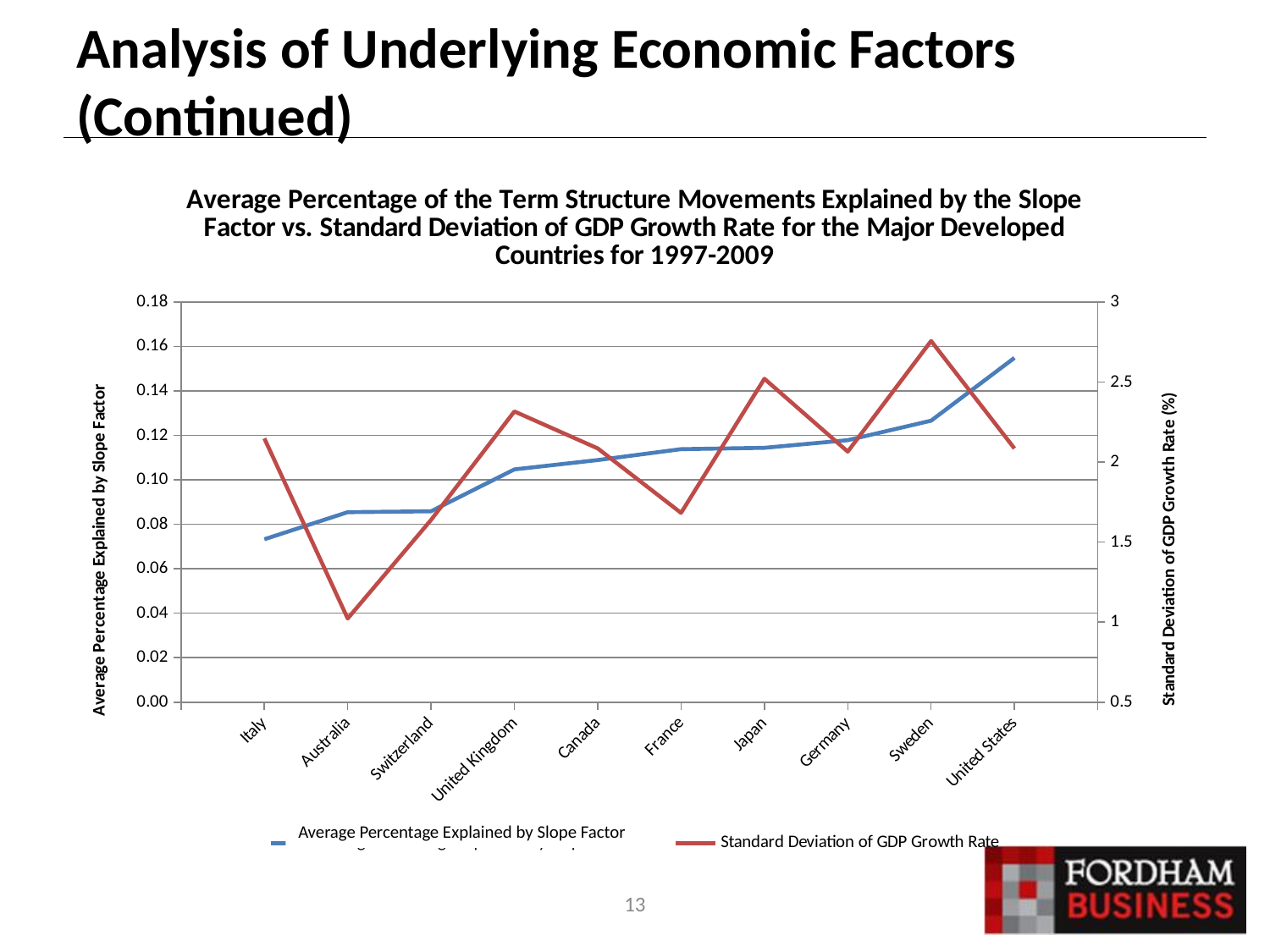
How many countries are plotted along the x axis? 10 Is the Standard Deviation of GDP Growth Rate for Australia greater or less than 1.5? less What is the label of the right-hand vertical axis? Standard Deviation of GDP Growth Rate (%) How many series does the legend list? 2 Which country has the highest Standard Deviation of GDP Growth Rate? Sweden Which country has the lowest Standard Deviation of GDP Growth Rate? Australia Does the Average Percentage Explained by Slope Factor generally rise or fall from Italy to the United States along the x axis? rise Is the Average Percentage Explained by Slope Factor for the United States greater or less than 0.14? greater What kind of chart is shown on the slide? line chart Which country has the highest value for Average Percentage Explained by Slope Factor? United States Is the Average Percentage Explained by Slope Factor for Italy greater or less than 0.08? less Which country has the lowest value for Average Percentage Explained by Slope Factor? Italy